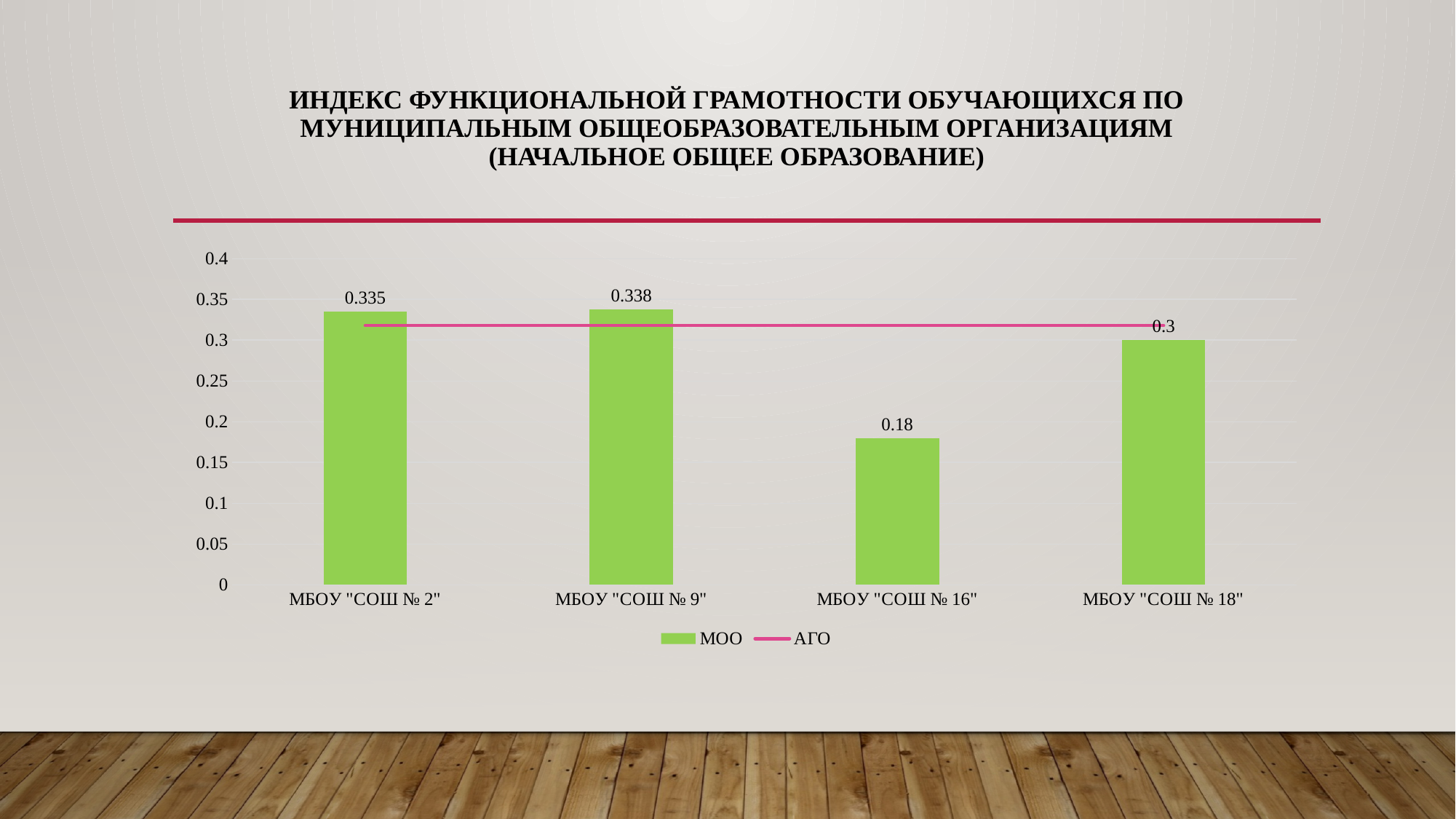
What is the value for МБОУ "СОШ № 9"? 0.338 Which is larger, the value for МБОУ "СОШ № 18" or МБОУ "СОШ № 16"? МБОУ "СОШ № 18" What is the value for МБОУ "СОШ № 18"? 0.3 Which school has the highest value? МБОУ "СОШ № 9" What is the value for МБОУ "СОШ № 16"? 0.18 How many schools are shown on the x axis? 4 How many series does the legend list? 2 What kind of chart is this? combination bar and line chart What is the difference between the values for МБОУ "СОШ № 2" and МБОУ "СОШ № 16"? 0.155 Which school has the lowest value? МБОУ "СОШ № 16" Is the value of the АГО line greater or less than 0.3? greater What is the value for МБОУ "СОШ № 2"? 0.335